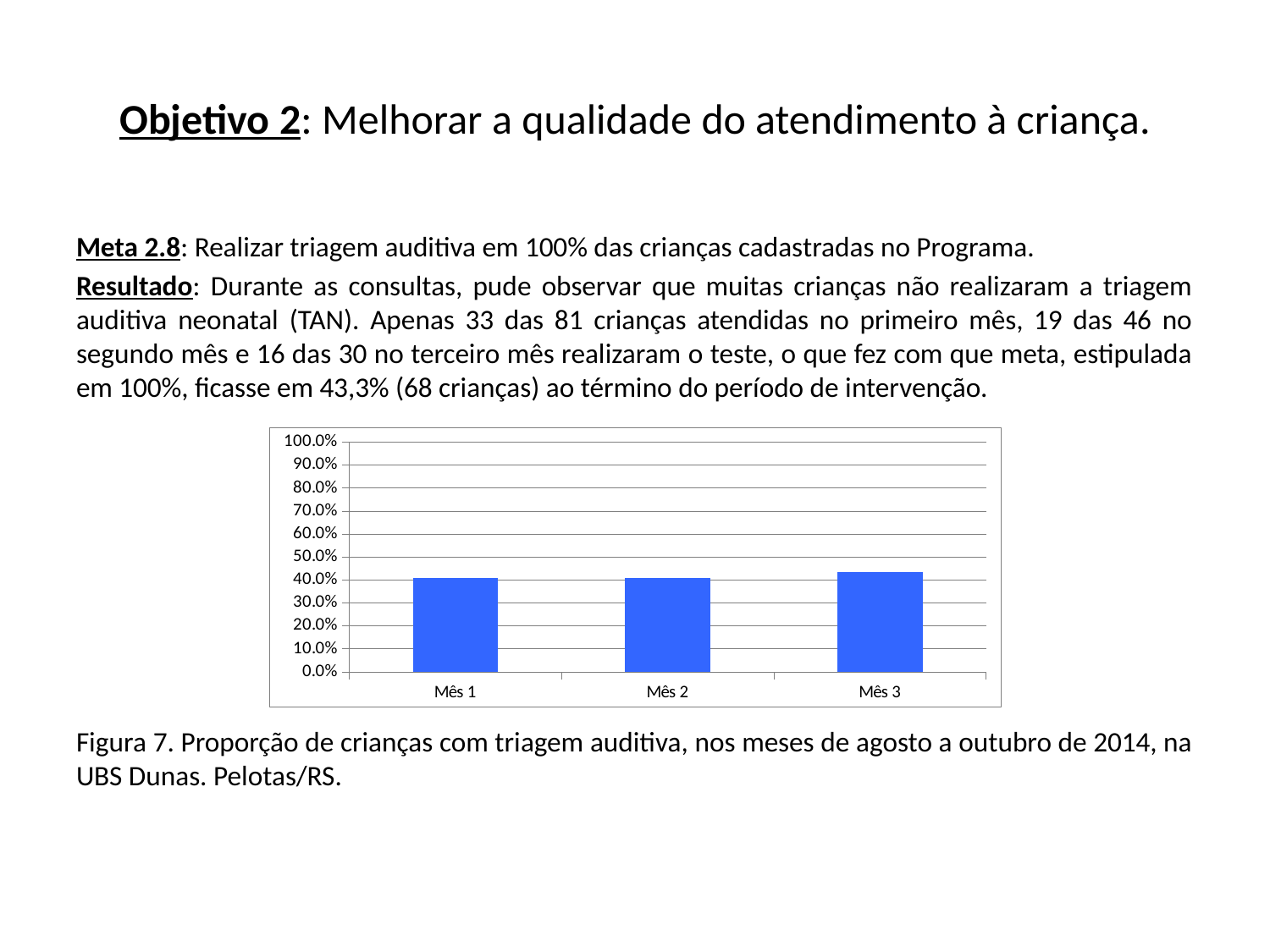
What is the highest value shown on the chart's vertical axis? 100.0% Is the value for Mês 1 greater or less than 50.0%? less What are the category labels on the horizontal axis of the chart? Mês 1, Mês 2, Mês 3 Is the value for Mês 3 greater or less than 40.0%? greater How many categories (months) are plotted in the chart? 3 Is the value for Mês 3 greater or less than 60.0%? less Which month has the tallest bar in the chart? Mês 3 What kind of chart is shown on the slide? bar chart